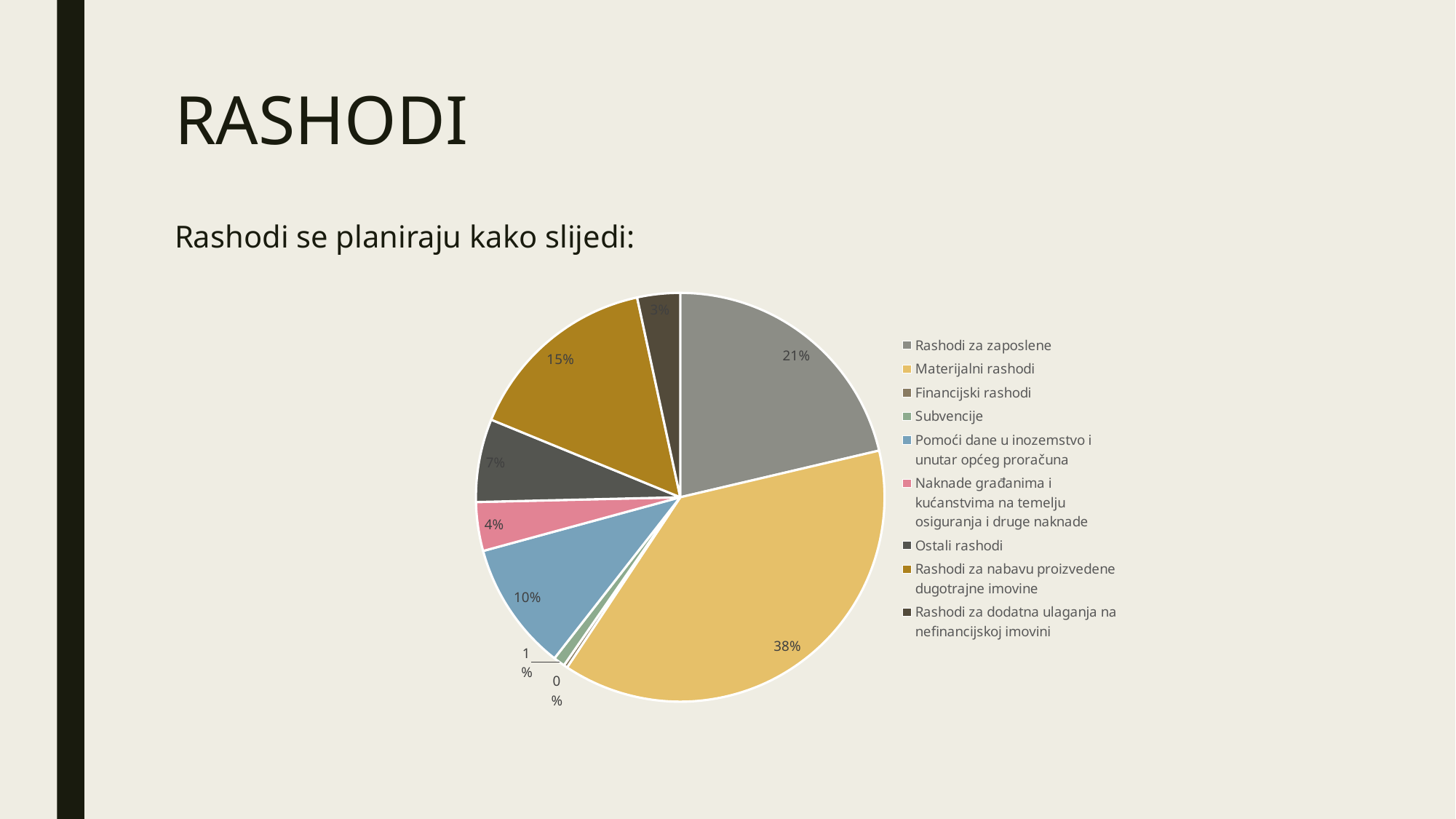
What kind of chart is shown on the slide? pie chart How many categories does the legend list? 9 What share of the pie does Naknade građanima i kućanstvima na temelju osiguranja i druge naknade have? 4% Which category has the smallest slice of the pie? Financijski rashodi What share of the pie does Pomoći dane u inozemstvo i unutar općeg proračuna have? 10% What is the difference between the shares of Materijalni rashodi and Rashodi za zaposlene? 17% What share of the pie does Rashodi za zaposlene have? 21% Which category has the largest slice of the pie? Materijalni rashodi Which is larger, the share for Ostali rashodi or the share for Naknade građanima i kućanstvima na temelju osiguranja i druge naknade? Ostali rashodi